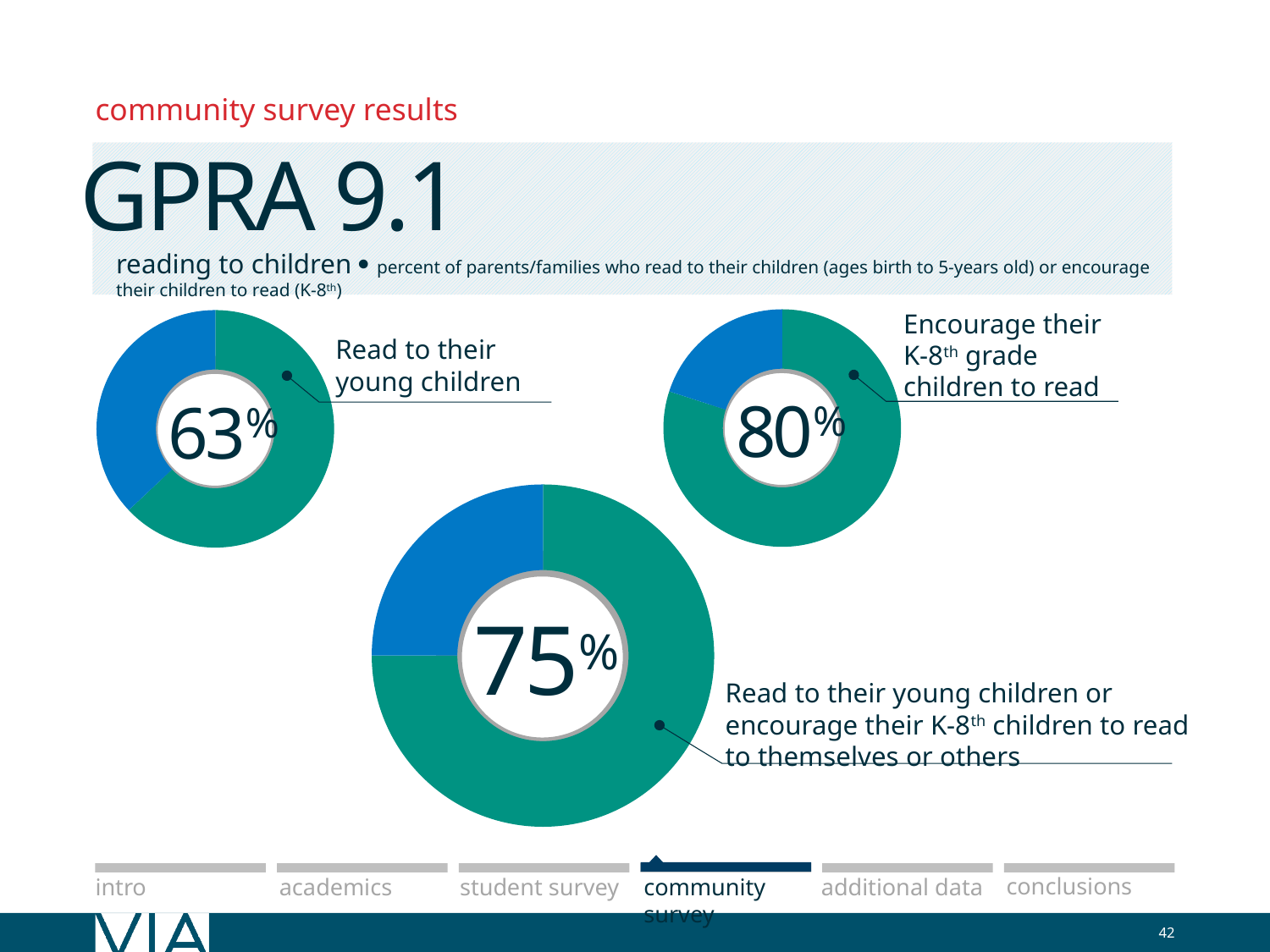
On the 'Read to their young children' chart, what share of the ring is shaded green? 63% What kind of chart is used to show the 63% value on the left of the slide? Donut (pie) chart How many donut charts are shown on the slide? 3 Across the three donut charts on the slide, which category has the lowest percentage? Read to their young children Which is larger: the percentage on the 'Read to their young children' chart or the percentage on the bottom-centre 'Read to their young children or encourage their K-8th children to read' chart? Read to their young children or encourage their K-8th children to read to themselves or others On the large chart at the bottom centre labelled 'Read to their young children or encourage their K-8th children to read to themselves or others', what percentage is shown? 75% On the chart labelled 'Encourage their K-8th grade children to read', what percentage is shown? 80% What is the difference between the percentage on the 'Encourage their K-8th grade children to read' chart and the percentage on the 'Read to their young children' chart? 17% On the chart labelled 'Read to their young children', what percentage is shown? 63% What is the title of the slide above the three charts? GPRA 9.1 What is the difference between the percentage on the bottom-centre chart (75%) and the percentage on the 'Encourage their K-8th grade children to read' chart? 5% Across the three donut charts on the slide, which category has the highest percentage? Encourage their K-8th grade children to read